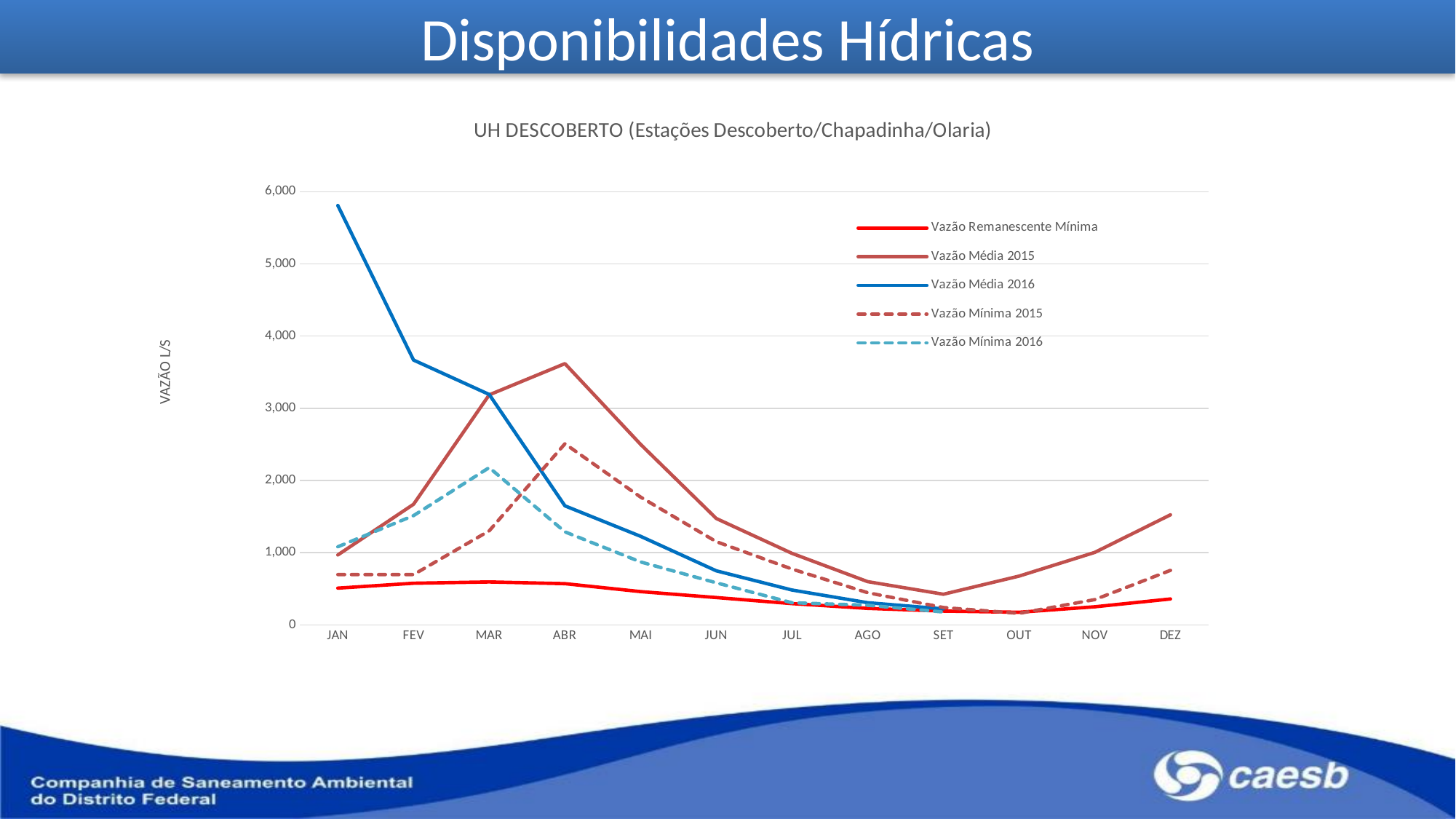
Does Vazão Média 2016 rise or fall from JAN to SET? fall What is the title of the chart? UH DESCOBERTO (Estações Descoberto/Chapadinha/Olaria) Is the value of Vazão Média 2015 in ABR greater or less than 3,000? greater In which month is Vazão Média 2015 highest? ABR What kind of chart is shown on the slide? line chart In JAN, which is larger: Vazão Média 2016 or Vazão Média 2015? Vazão Média 2016 What is the label of the vertical axis? VAZÃO L/S In which month does Vazão Mínima 2016 reach its peak? MAR How many months are plotted along the x axis? 12 Is the value of Vazão Média 2016 in JAN greater or less than 5,000? greater How many series does the legend list? 5 In which month is Vazão Média 2016 highest? JAN